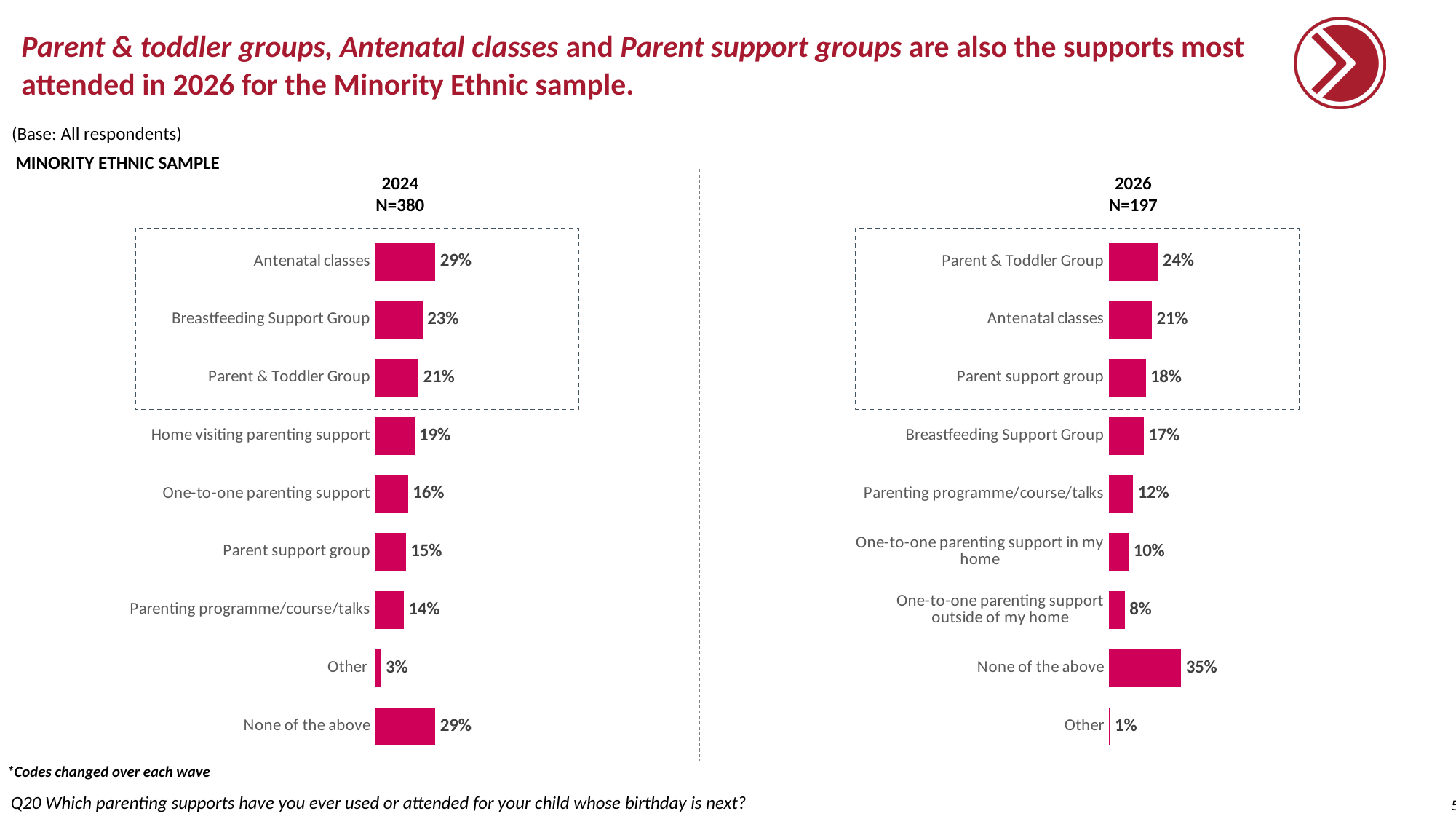
Which is larger: Parent support group in the 2024 chart or Parent support group in the 2026 chart? 2026 (18%) In the 2024 chart, which category has the lowest value? Other In the 2026 chart, which category has the lowest value? Other In the 2024 chart, what percentage attended Antenatal classes? 29% In the 2024 chart, what is the value for Home visiting parenting support? 19% In the 2024 chart, what is the difference between Antenatal classes and Parent & Toddler Group? 8% In the 2026 chart, what is the value for None of the above? 35% In the 2026 chart, what percentage attended a Parent & Toddler Group? 24% What type of chart is used on this slide? Bar chart How many categories are shown in the 2026 chart? 9 In the 2026 chart, what is the difference between Parent & Toddler Group and Breastfeeding Support Group? 7% In the 2026 chart, which category has the highest value? None of the above